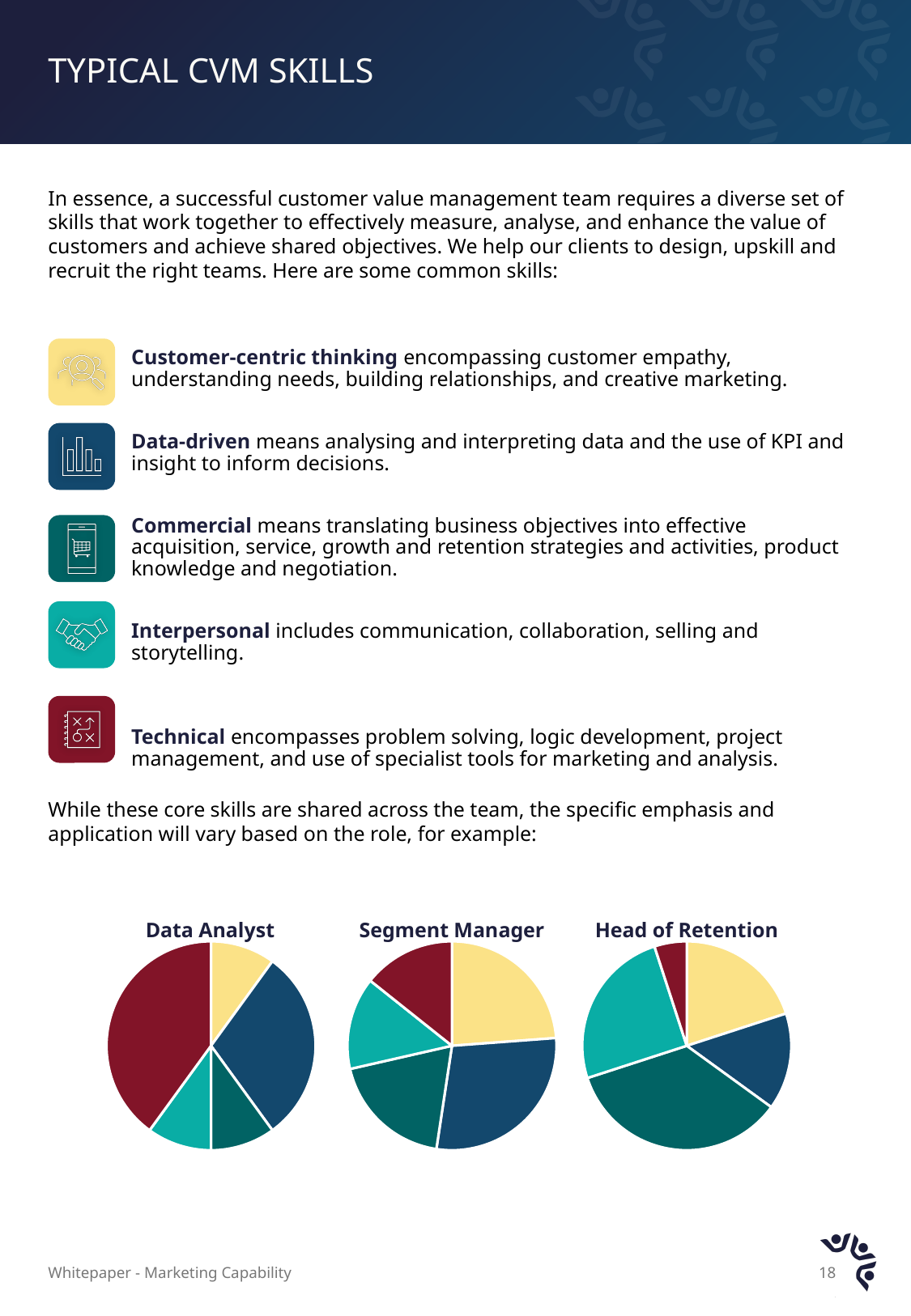
What are the titles of the three pie charts, from left to right? Data Analyst, Segment Manager, Head of Retention How many slices does the Data Analyst pie chart have? 5 In the Head of Retention pie chart, which is larger, the yellow slice or the dark red slice? Yellow Which pie chart is positioned in the middle of the slide? Segment Manager How many slices does the Segment Manager pie chart have? 5 What kind of chart is used for the Data Analyst chart? Pie chart How many pie charts are shown on the slide? 3 In the Data Analyst pie chart, which colour slice is the largest? Dark red In the Head of Retention pie chart, which colour slice is the smallest? Dark red In the Data Analyst pie chart, which is larger, the dark red slice or the dark blue slice? Dark red In the Head of Retention pie chart, which colour slice is the largest? Dark teal